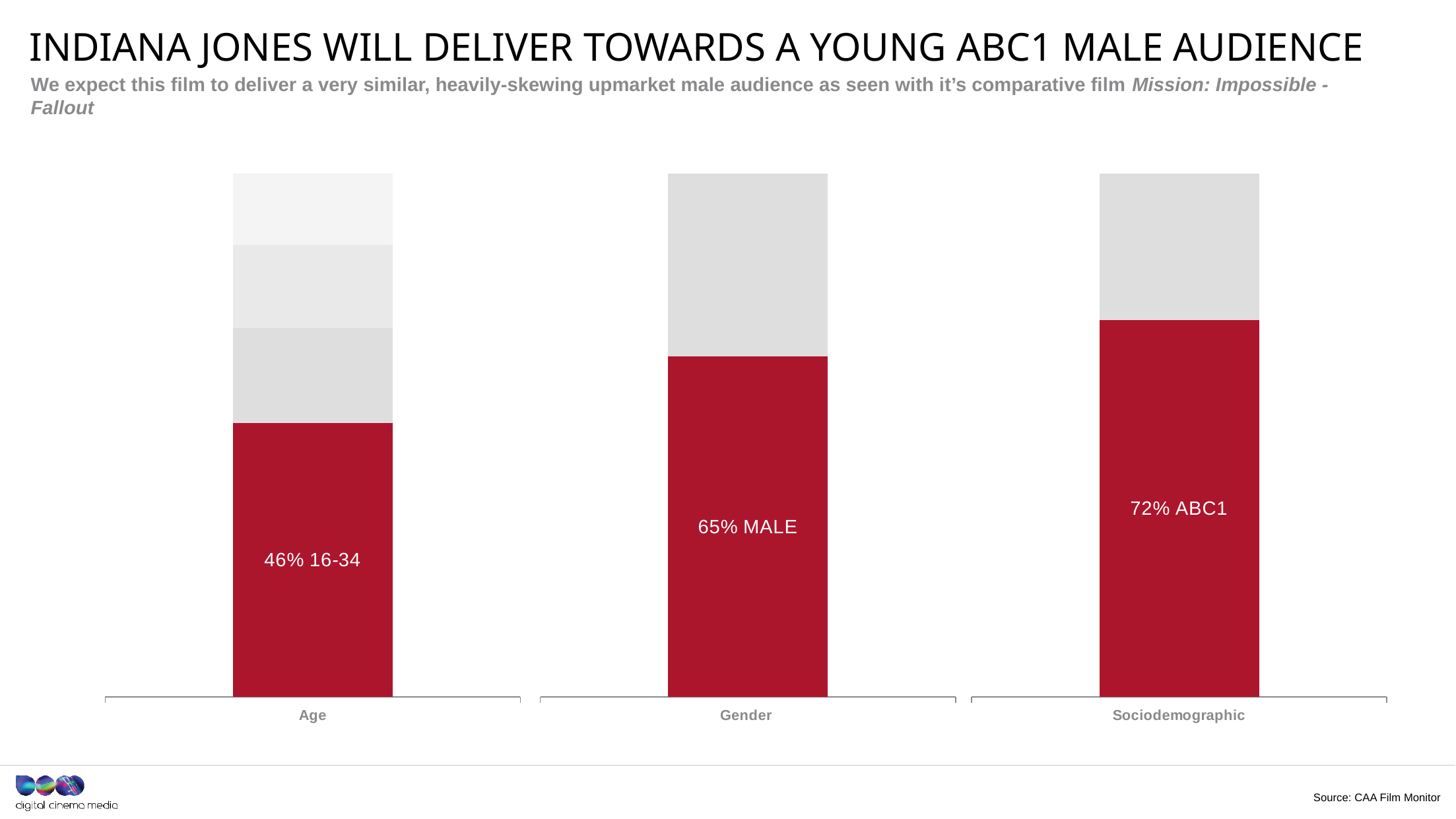
In the Age chart, what share of the audience is labelled as 16-34? 46% What colour is used for the labelled segment in each chart? Red Across the three charts, which labelled red segment has the lowest value? 46% 16-34 In the Age chart, how many segments make up the stacked bar? 4 Is the labelled value in the Gender chart (MALE) larger or smaller than the labelled value in the Age chart (16-34)? larger What kind of chart is used on this slide? Stacked bar chart Across the three charts, which labelled red segment has the highest value? 72% ABC1 What is the difference in percentage points between the ABC1 value in the Sociodemographic chart and the 16-34 value in the Age chart? 26 In the Sociodemographic chart, what percentage of the audience is ABC1? 72% How many separate charts are shown on the slide? 3 What is the difference in percentage points between the ABC1 value in the Sociodemographic chart and the MALE value in the Gender chart? 7 In the Gender chart, what percentage of the audience is male? 65%